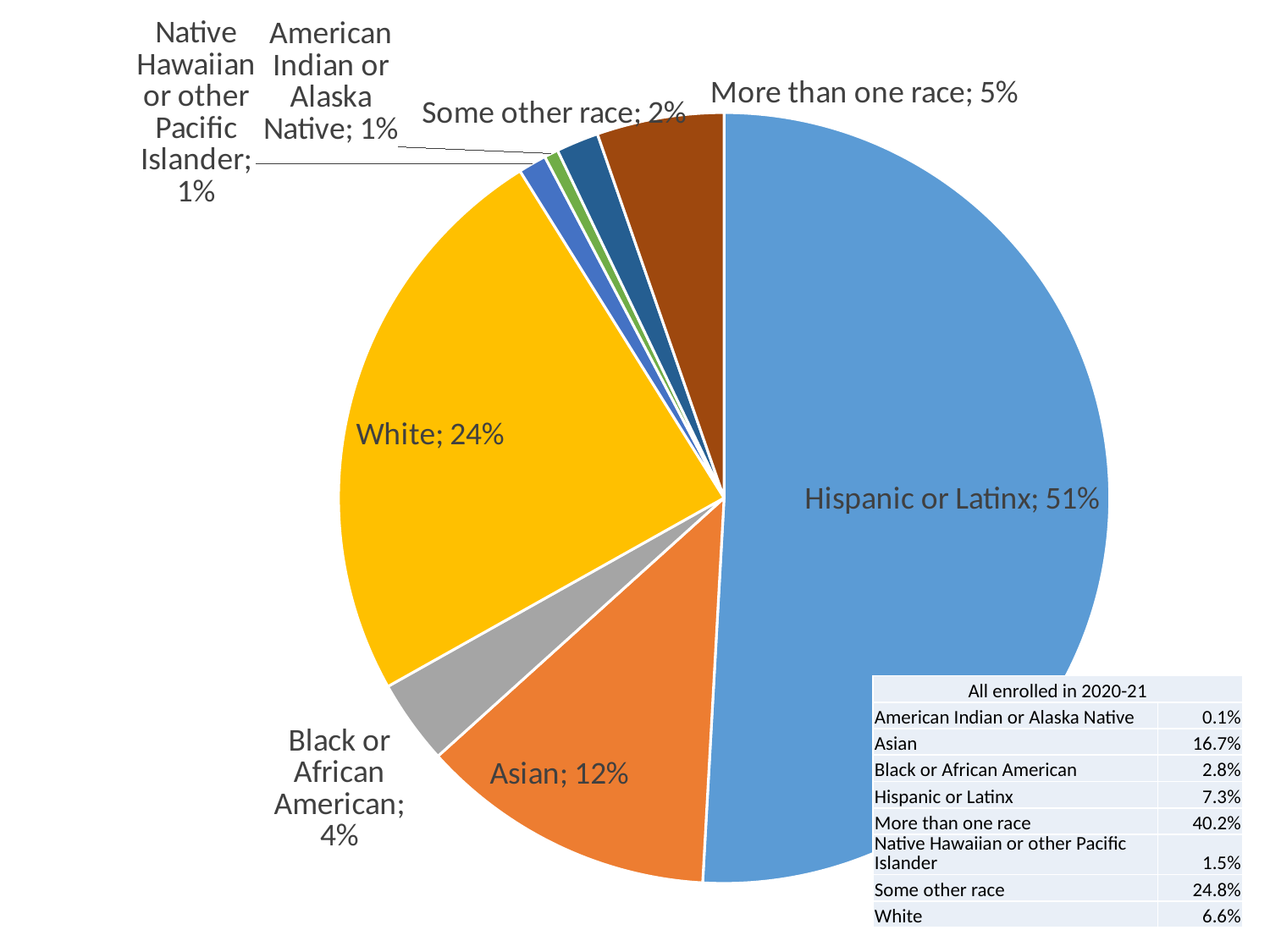
In the pie chart, what is the value for Some other race? 2% In the pie chart, which is larger, White or Asian? White In the pie chart, what is the value for American Indian or Alaska Native? 1% In the pie chart, what is the value for More than one race? 5% What kind of chart is shown on the slide? pie chart In the pie chart, what is the difference between the Hispanic or Latinx share and the White share? 27 percentage points Which category has the largest slice in the pie chart? Hispanic or Latinx In the pie chart, what is the value for Asian? 12% How many slices does the pie chart have? 8 In the pie chart, what is the value for White? 24% In the pie chart, what is the value for Black or African American? 4% In the pie chart, what share does Hispanic or Latinx have? 51%